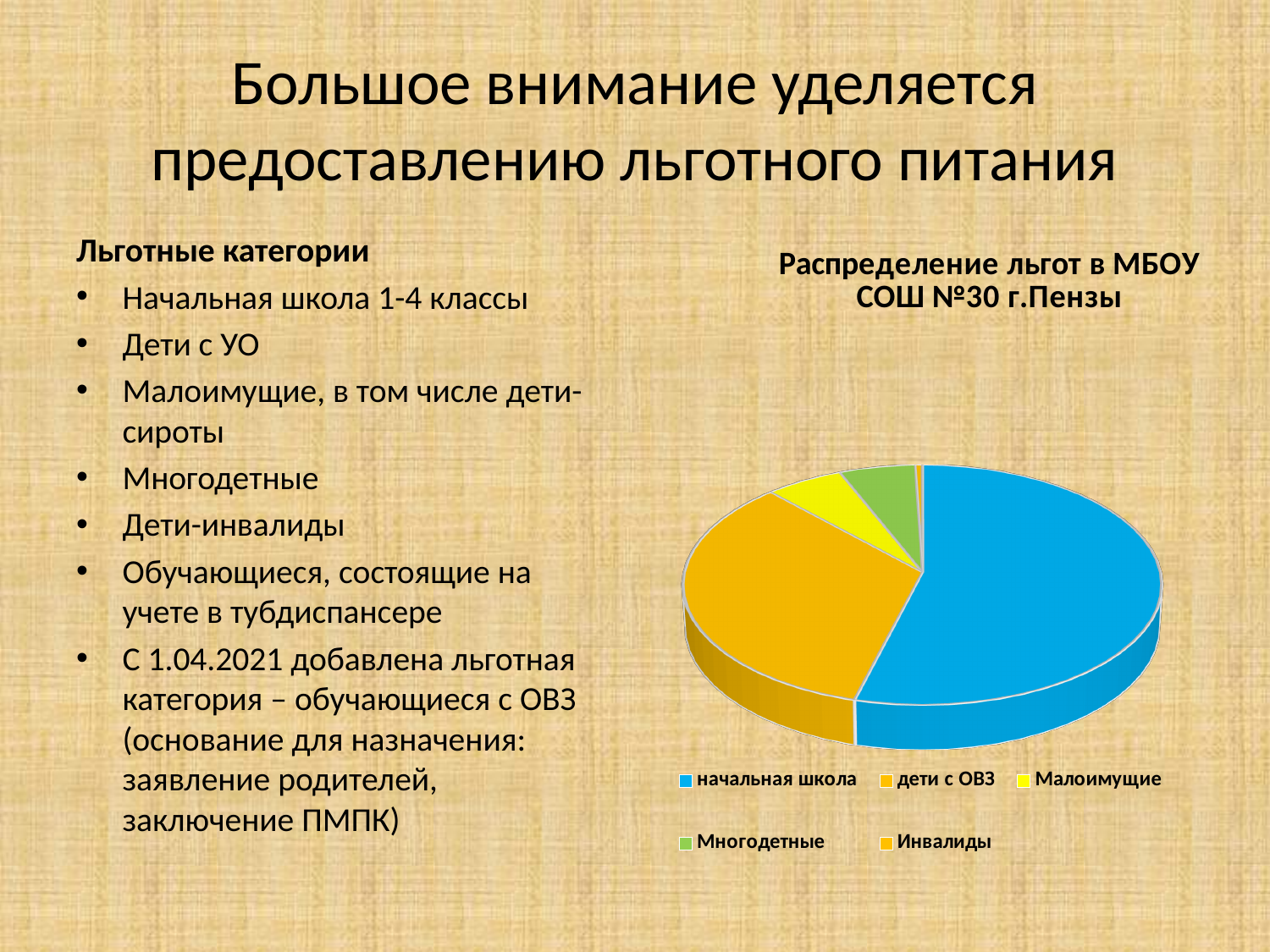
Which category has the smallest slice of the pie? Инвалиды What colour is the slice for начальная школа? blue Which slice is larger: Многодетные or Инвалиды? Многодетные Which slice is larger: дети с ОВЗ or Малоимущие? дети с ОВЗ Which slice is larger: начальная школа or дети с ОВЗ? начальная школа What is the title of the chart? Распределение льгот в МБОУ СОШ №30 г.Пензы What kind of chart is shown on the slide? pie chart How many categories does the pie chart show? 5 Which category has the largest slice of the pie? начальная школа